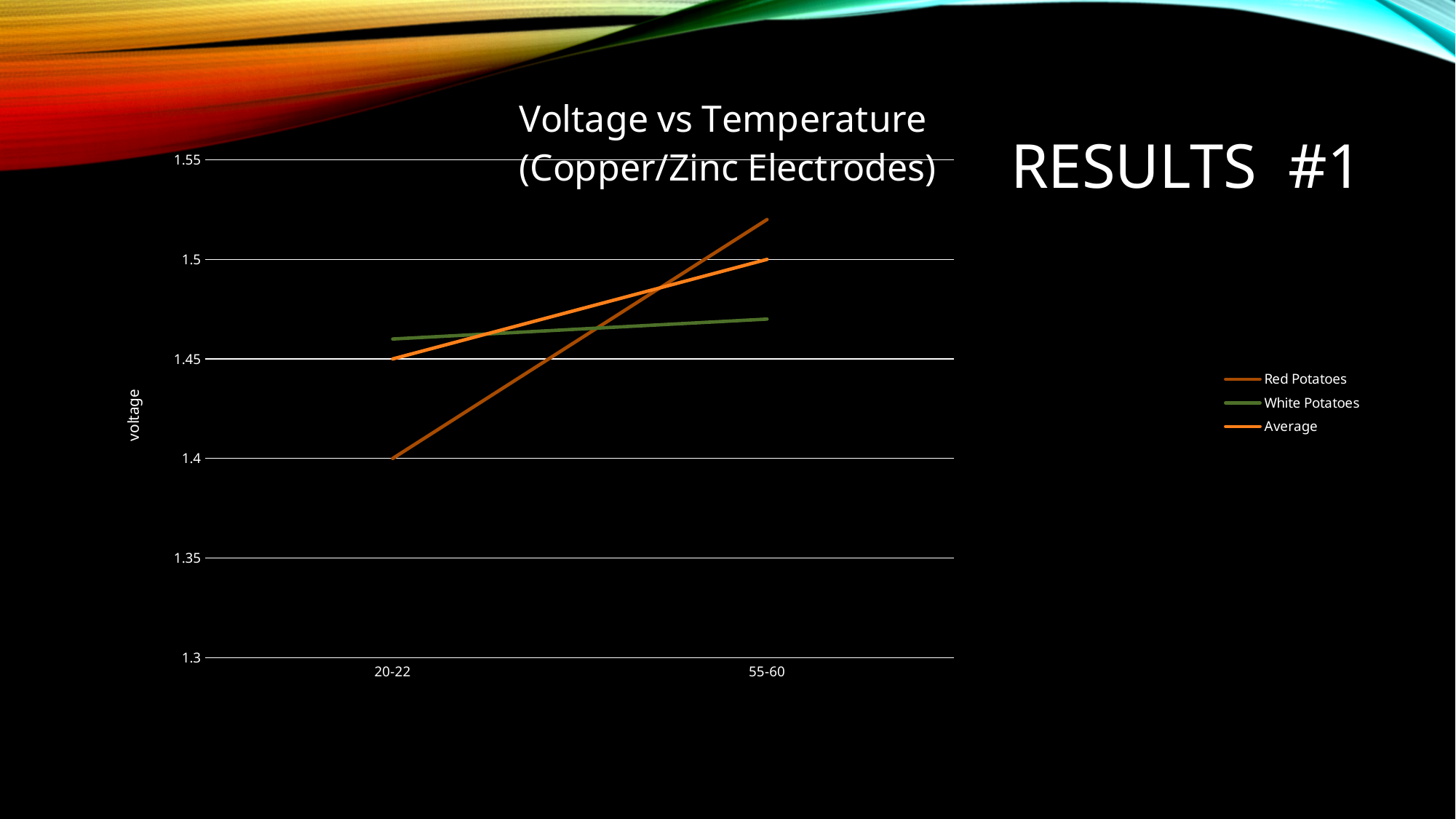
What kind of chart is shown on the slide? line chart Is the voltage for Red Potatoes at 55-60 greater or less than 1.5? greater What is the Average voltage at 55-60? 1.5 How many series does the legend list? 3 Is the voltage for White Potatoes at 20-22 greater or less than 1.45? greater At 20-22, which has the higher voltage, Red Potatoes or White Potatoes? White Potatoes Does the Red Potatoes voltage rise or fall from 20-22 to 55-60? rise What is the Average voltage at 20-22? 1.45 By how much does the Average voltage increase from 20-22 to 55-60? 0.05 How many temperature categories are shown on the x axis? 2 Which series has the highest voltage at 55-60? Red Potatoes What is the voltage for Red Potatoes at 20-22? 1.4